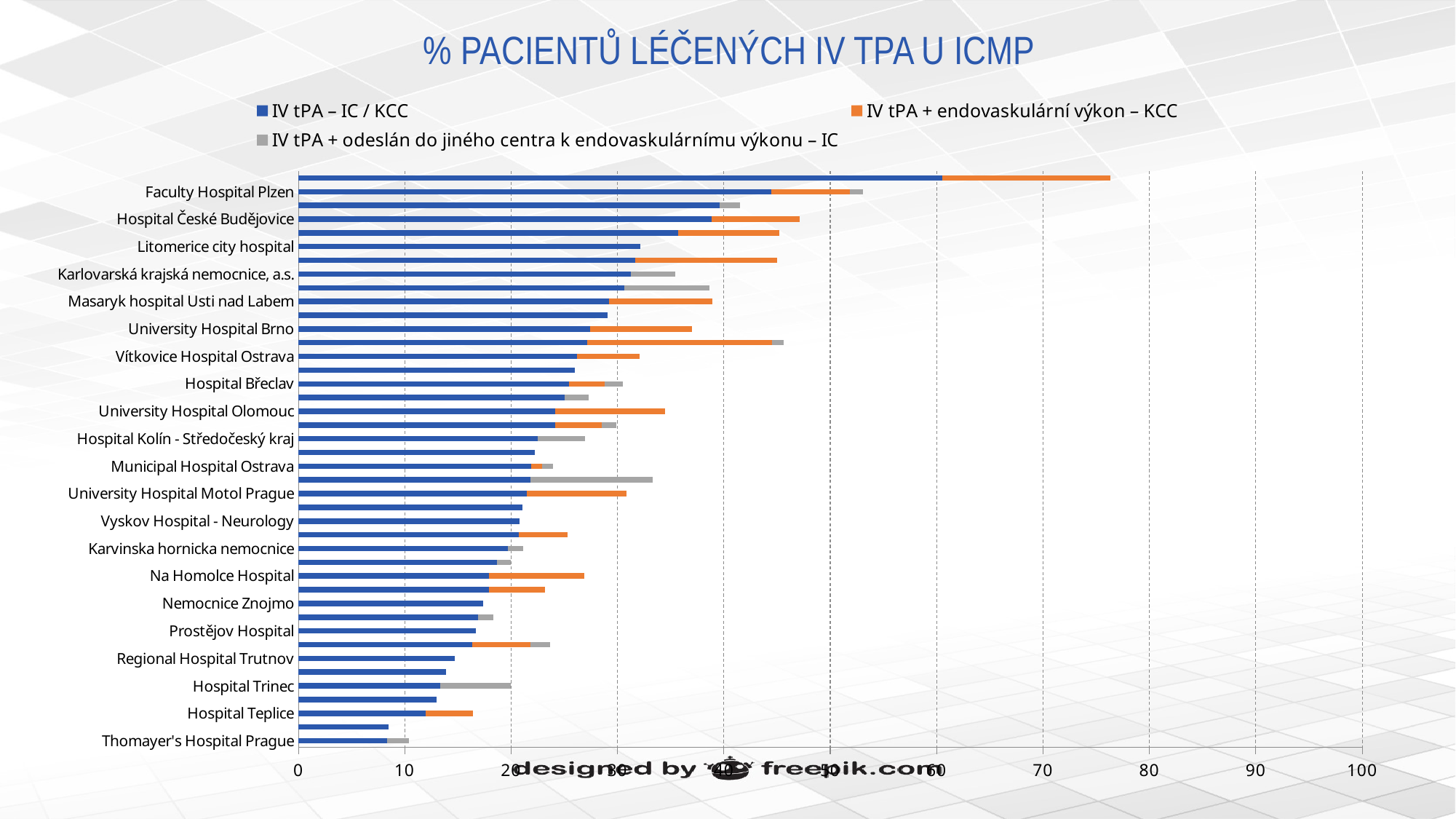
Do the IV tPA – IC / KCC bars get shorter or longer going from the top of the chart to the bottom? shorter What kind of chart is shown on the slide? Stacked bar chart Which series is shown in orange in the legend? IV tPA + endovaskulární výkon – KCC How many series does the legend list? 3 What is the title of the chart? % PACIENTŮ LÉČENÝCH IV TPA U ICMP Is the IV tPA – IC / KCC value for Thomayer's Hospital Prague greater or less than 10? less Is the IV tPA – IC / KCC value for Faculty Hospital Plzen greater or less than 40? greater Is the IV tPA – IC / KCC value for Regional Hospital Trutnov greater or less than 20? less Which has the larger IV tPA – IC / KCC value, Na Homolce Hospital or Hospital Teplice? Na Homolce Hospital Which has the larger IV tPA – IC / KCC value, Faculty Hospital Plzen or Thomayer's Hospital Prague? Faculty Hospital Plzen